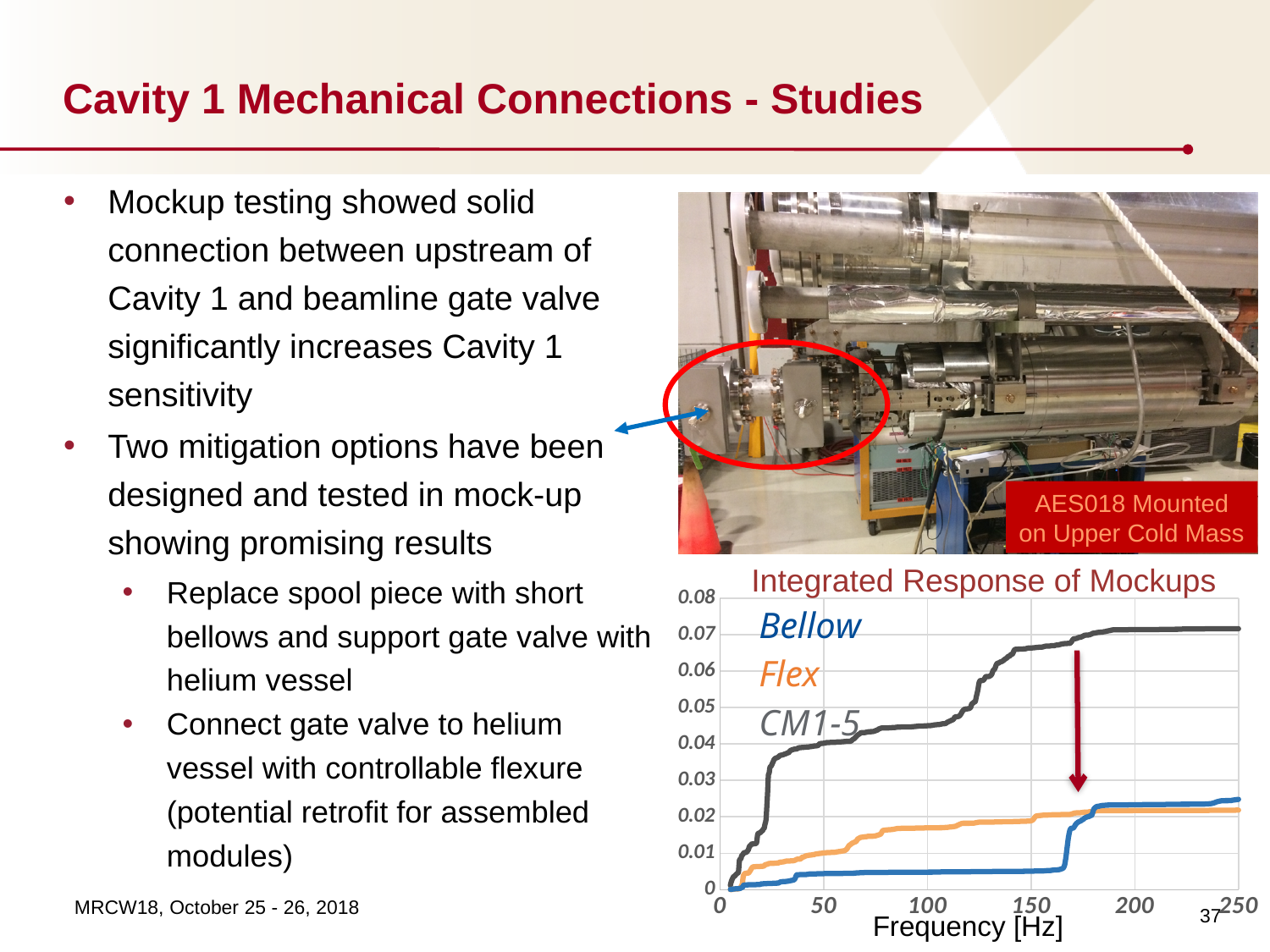
In the 'Integrated Response of Mockups' chart, which series has the highest value at 250 Hz? CM1-5 In the 'Integrated Response of Mockups' chart, is the value of Flex at 100 Hz greater or less than 0.01? greater What is the x-axis label of the 'Integrated Response of Mockups' chart? Frequency [Hz] What is the title of the chart on the slide? Integrated Response of Mockups How many series are plotted in the 'Integrated Response of Mockups' chart? 3 In the 'Integrated Response of Mockups' chart, is the value of CM1-5 at 250 Hz greater or less than 0.07? greater In the 'Integrated Response of Mockups' chart, is the value of CM1-5 at 50 Hz greater or less than 0.03? greater In the 'Integrated Response of Mockups' chart, does the CM1-5 series rise or fall as frequency increases? rise In the 'Integrated Response of Mockups' chart, at 50 Hz, which is larger: Flex or Bellow? Flex What kind of chart is 'Integrated Response of Mockups'? line chart In the 'Integrated Response of Mockups' chart, which series has the lowest value at 100 Hz? Bellow